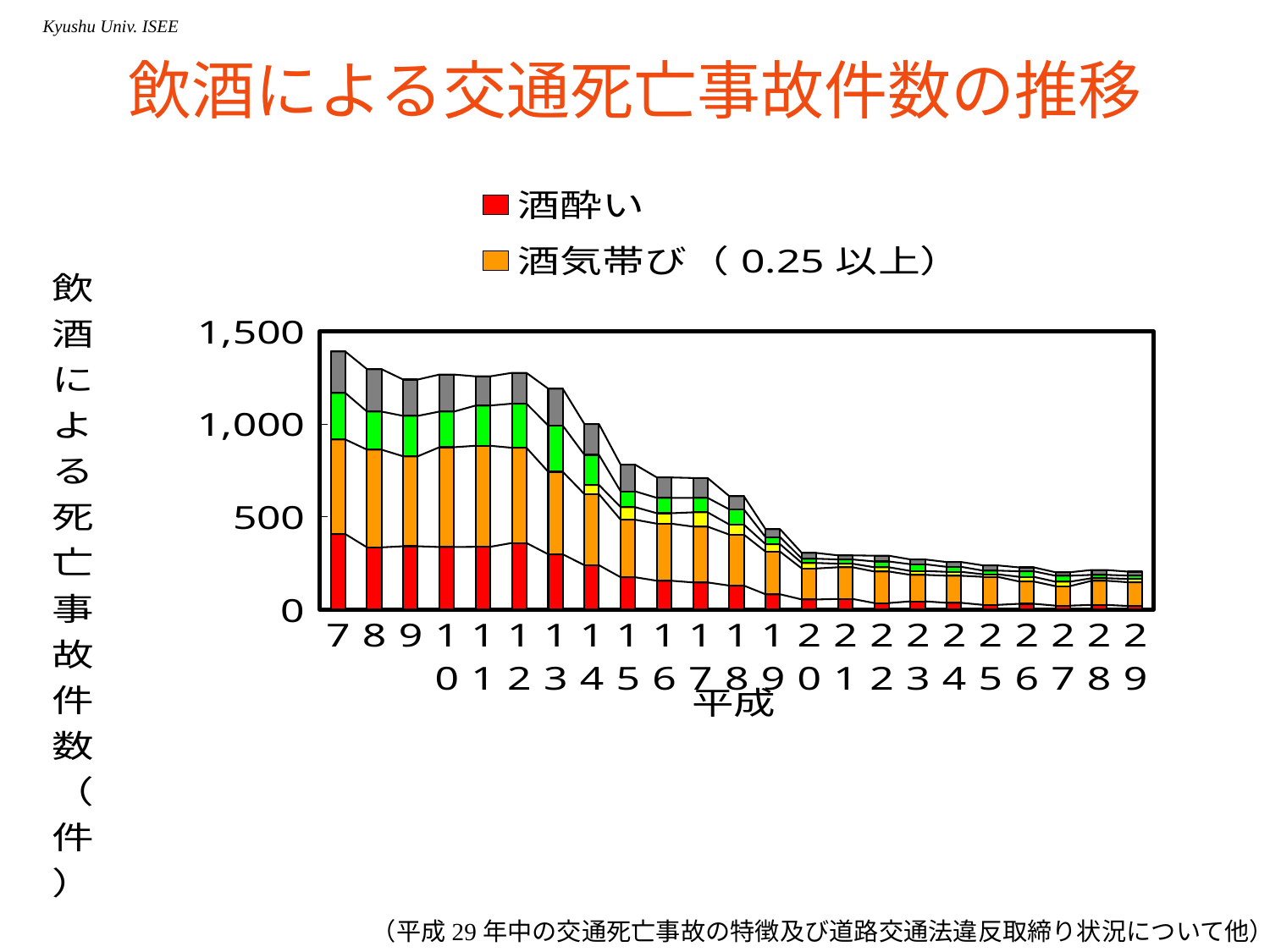
Which is larger, the 酒酔い value for 平成12 or for 平成20? 平成12 Do the total numbers of fatal accidents rise or fall from 平成7 to 平成29? fall Is the total value for 平成20 greater or less than 500? less What kind of chart is shown on the slide? stacked bar chart What is the title of the chart? 飲酒による交通死亡事故件数の推移 Is the 酒酔い value for 平成7 greater or less than 500? less Which year has the highest total number of drunk-driving fatal accidents? 平成7 How many series does the legend list? 2 Is the total value for 平成7 greater or less than 1,000? greater Which is larger, the total for 平成7 or the total for 平成29? 平成7 How many years (categories) are plotted along the x axis? 23